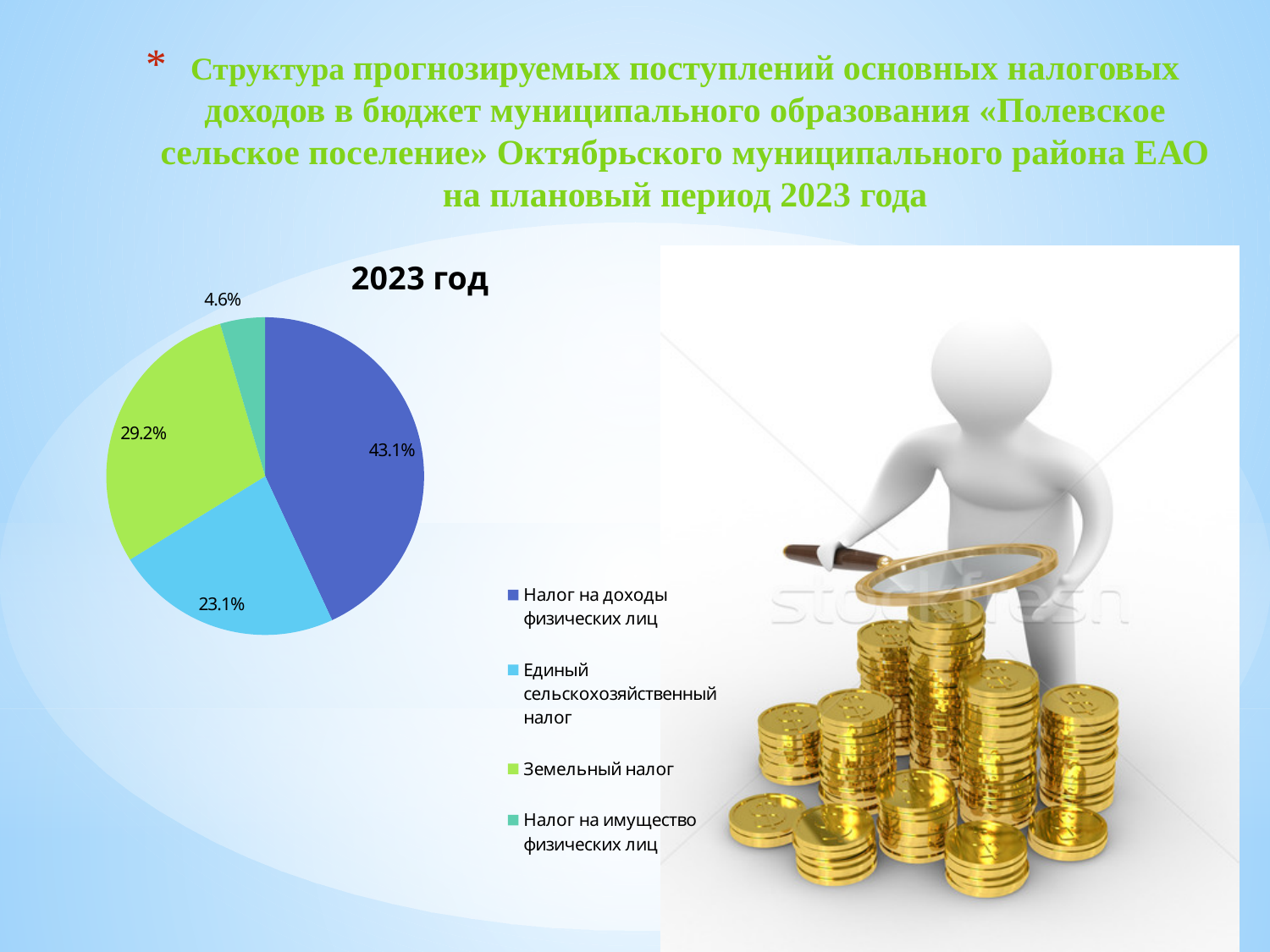
What share of the pie does "Единый сельскохозяйственный налог" have? 23.1% What share of the pie does "Налог на доходы физических лиц" have? 43.1% Which is larger: the share of "Земельный налог" or the share of "Единый сельскохозяйственный налог"? Земельный налог Which category has the smallest slice of the pie? Налог на имущество физических лиц What is the difference between the shares of "Налог на доходы физических лиц" and "Земельный налог"? 13.9% What is the title of the chart? 2023 год What colour is the slice for "Земельный налог"? green What kind of chart is shown on the slide? pie chart What share of the pie does "Земельный налог" have? 29.2% What share of the pie does "Налог на имущество физических лиц" have? 4.6% Which category has the largest slice of the pie? Налог на доходы физических лиц How many categories does the pie chart have? 4